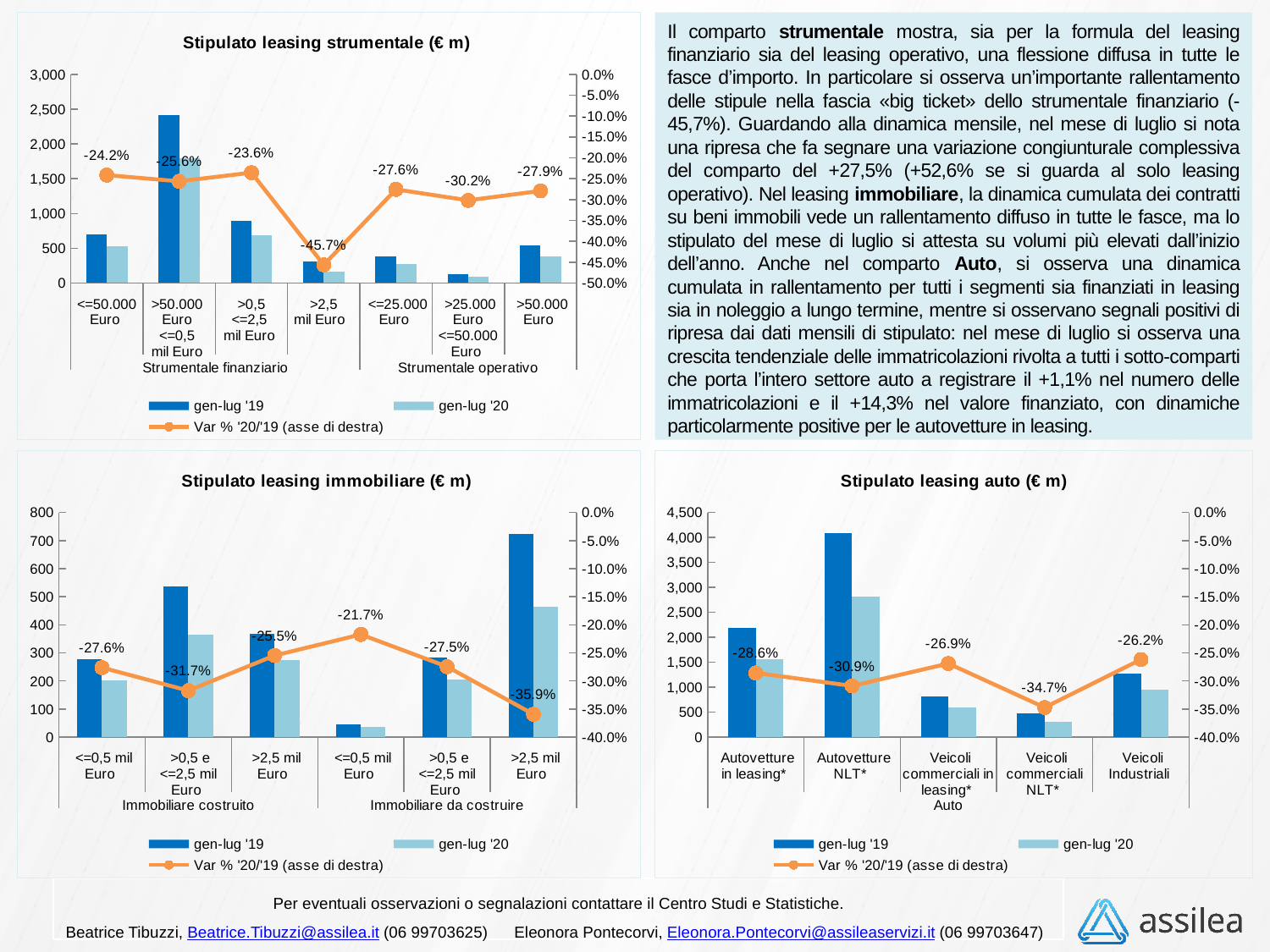
In the 'Stipulato leasing immobiliare (€ m)' chart, is the gen-lug '19 value for '>2,5 mil Euro' under Immobiliare da costruire greater or less than 600? greater In the 'Stipulato leasing strumentale (€ m)' chart, which category has the lowest Var % '20/'19 value? >2,5 mil Euro (Strumentale finanziario) What kind of chart is the 'Stipulato leasing auto (€ m)' chart? Combined bar and line chart In the 'Stipulato leasing auto (€ m)' chart, what is the Var % '20/'19 value for 'Veicoli commerciali NLT*'? -34.7% In the 'Stipulato leasing strumentale (€ m)' chart, which gen-lug '19 bar is taller: '>50.000 Euro <=0,5 mil Euro' or '>0,5 <=2,5 mil Euro'? >50.000 Euro <=0,5 mil Euro In the 'Stipulato leasing immobiliare (€ m)' chart, which category has the highest (least negative) Var % '20/'19 value? <=0,5 mil Euro (Immobiliare da costruire) How many series does the legend of the 'Stipulato leasing strumentale (€ m)' chart list? 3 In the 'Stipulato leasing immobiliare (€ m)' chart, what is the difference in percentage points between the Var % '20/'19 for '<=0,5 mil Euro' (Immobiliare da costruire, -21.7%) and '>2,5 mil Euro' (Immobiliare da costruire, -35.9%)? 14.2 percentage points How many categories are shown on the x axis of the 'Stipulato leasing strumentale (€ m)' chart? 7 In the 'Stipulato leasing auto (€ m)' chart, which category has the tallest gen-lug '19 bar? Autovetture NLT* In the 'Stipulato leasing strumentale (€ m)' chart, what is the Var % '20/'19 value for the '>2,5 mil Euro' category under Strumentale finanziario? -45.7% In the 'Stipulato leasing immobiliare (€ m)' chart, what is the Var % '20/'19 value for '>2,5 mil Euro' under Immobiliare da costruire? -35.9%